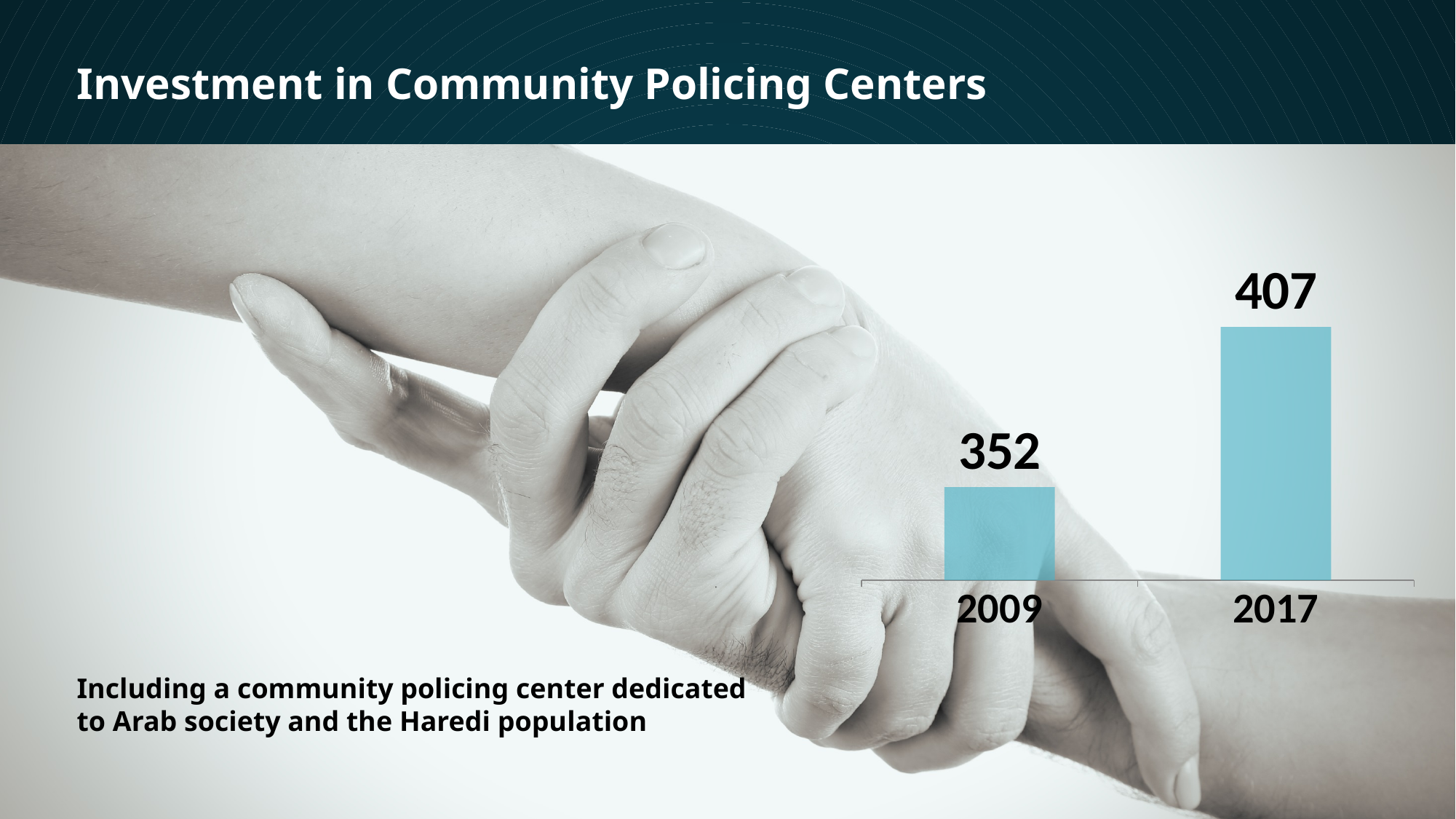
Which year has the higher value? 2017 What kind of chart is shown on the slide? bar chart What is the value for 2009? 352 Which year has the lower value? 2009 Is the value for 2017 larger or smaller than the value for 2009? larger What is the difference between the 2017 value and the 2009 value? 55 What is the value for 2017? 407 What colour are the bars in the chart? light blue What is the title of the slide containing the chart? Investment in Community Policing Centers Do the values rise or fall from 2009 to 2017? rise How many bars are shown in the chart? 2